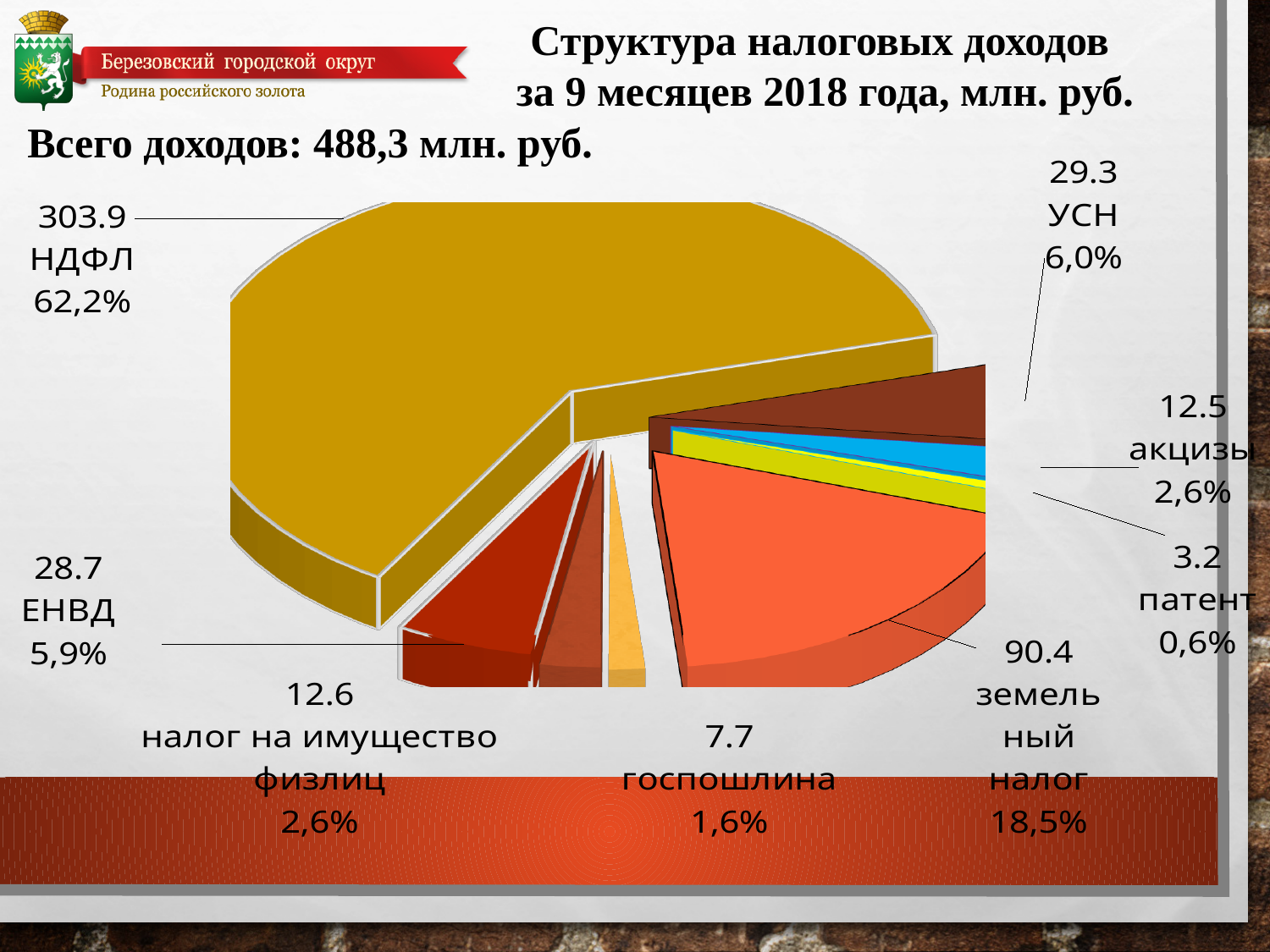
Which is larger, the value for ЕНВД or the value for акцизы? ЕНВД What is the value for УСН? 29.3 Which category has the smallest slice of the pie? патент What is the difference between the value for земельный налог and the value for УСН? 61.1 How many slices does the pie chart have? 8 What share of the pie does ЕНВД represent? 5,9% What is the value for НДФЛ? 303.9 What share of the pie does земельный налог represent? 18,5% What kind of chart is shown on the slide? pie chart What is the value for госпошлина? 7.7 What total income is stated on the slide? 488,3 млн. руб. Which category has the largest slice of the pie? НДФЛ